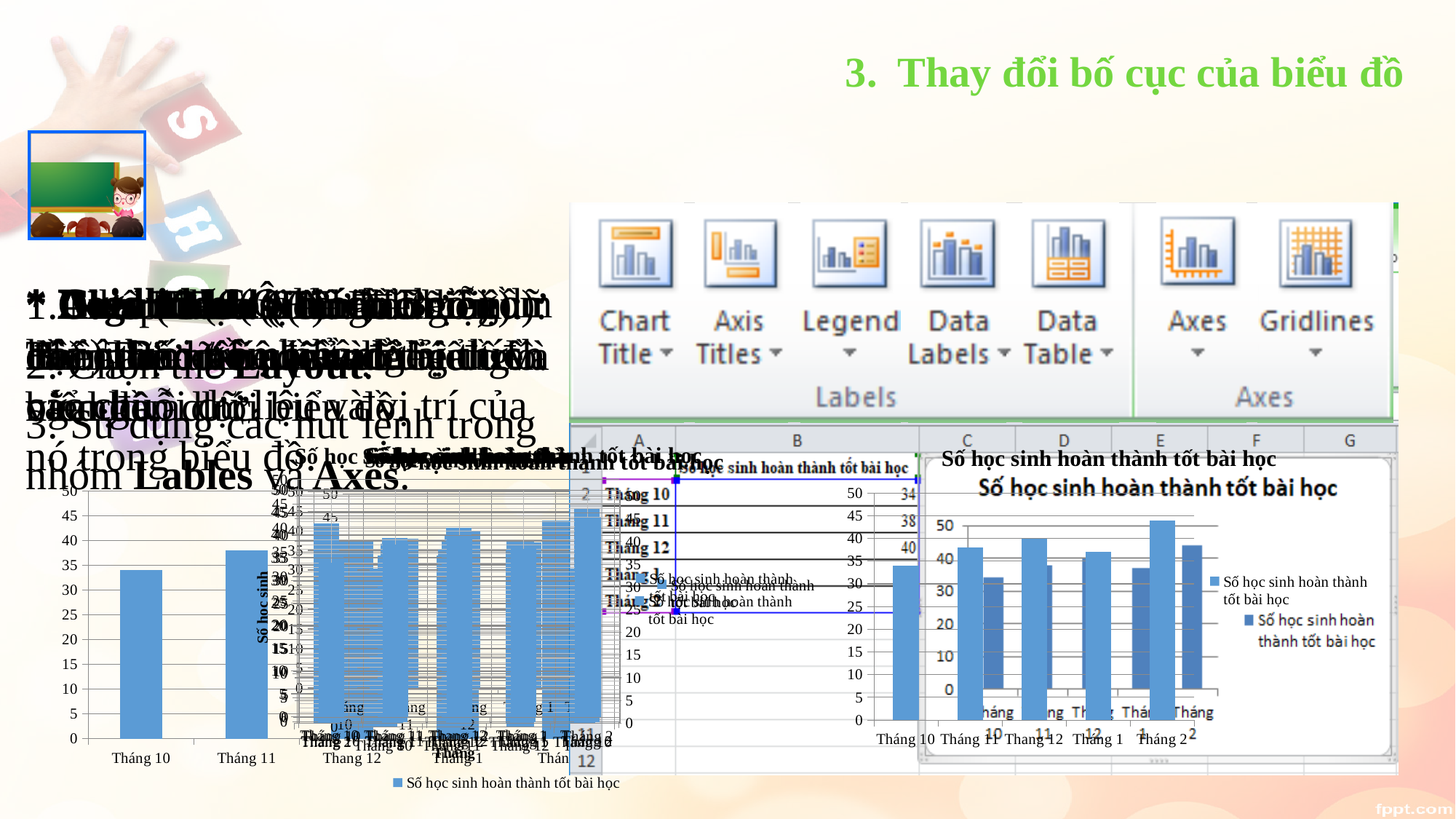
In the leftmost chart, is the value for Tháng 10 greater or less than 30? greater How many categories are shown along the x axis of the rightmost chart (Tháng 10 to Tháng 2)? 5 What kind of chart is the leftmost chart on the slide? bar chart In the leftmost chart, is the value for Tháng 10 greater or less than 40? less In the leftmost chart, which is larger, the value for Tháng 10 or the value for Tháng 11? Tháng 11 What is the highest tick value shown on the vertical axis of the leftmost chart? 50 How many series does the legend of the leftmost chart list? 1 In the leftmost chart, is the value for Tháng 11 greater or less than 35? greater What is the legend entry shown under the leftmost chart? Số học sinh hoàn thành tốt bài học